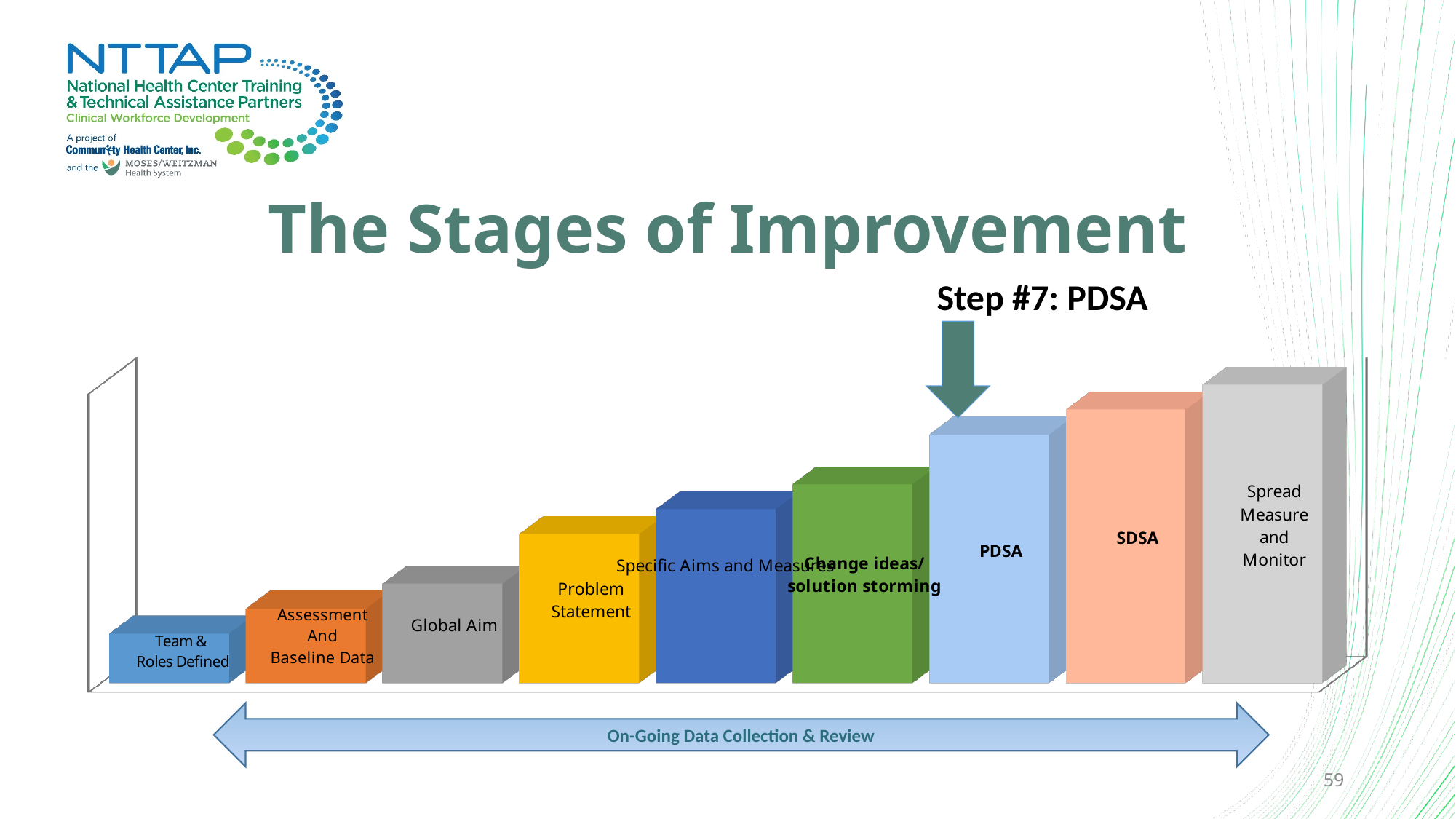
How many bars (stages) are shown in the chart? 9 Which bar is taller, PDSA or Global Aim? PDSA What kind of chart is shown on the slide? bar chart Which stage is the first (leftmost) bar in the chart? Team & Roles Defined Which stage has the shortest bar? Team & Roles Defined What is the title of the chart on the slide? The Stages of Improvement Which bar is taller, SDSA or Problem Statement? SDSA Which bar is shorter, Assessment And Baseline Data or Change ideas/solution storming? Assessment And Baseline Data Which stage does the 'Step #7: PDSA' arrow point to? PDSA Do the bar heights rise or fall from left to right across the chart? rise Which stage has the tallest bar? Spread Measure and Monitor